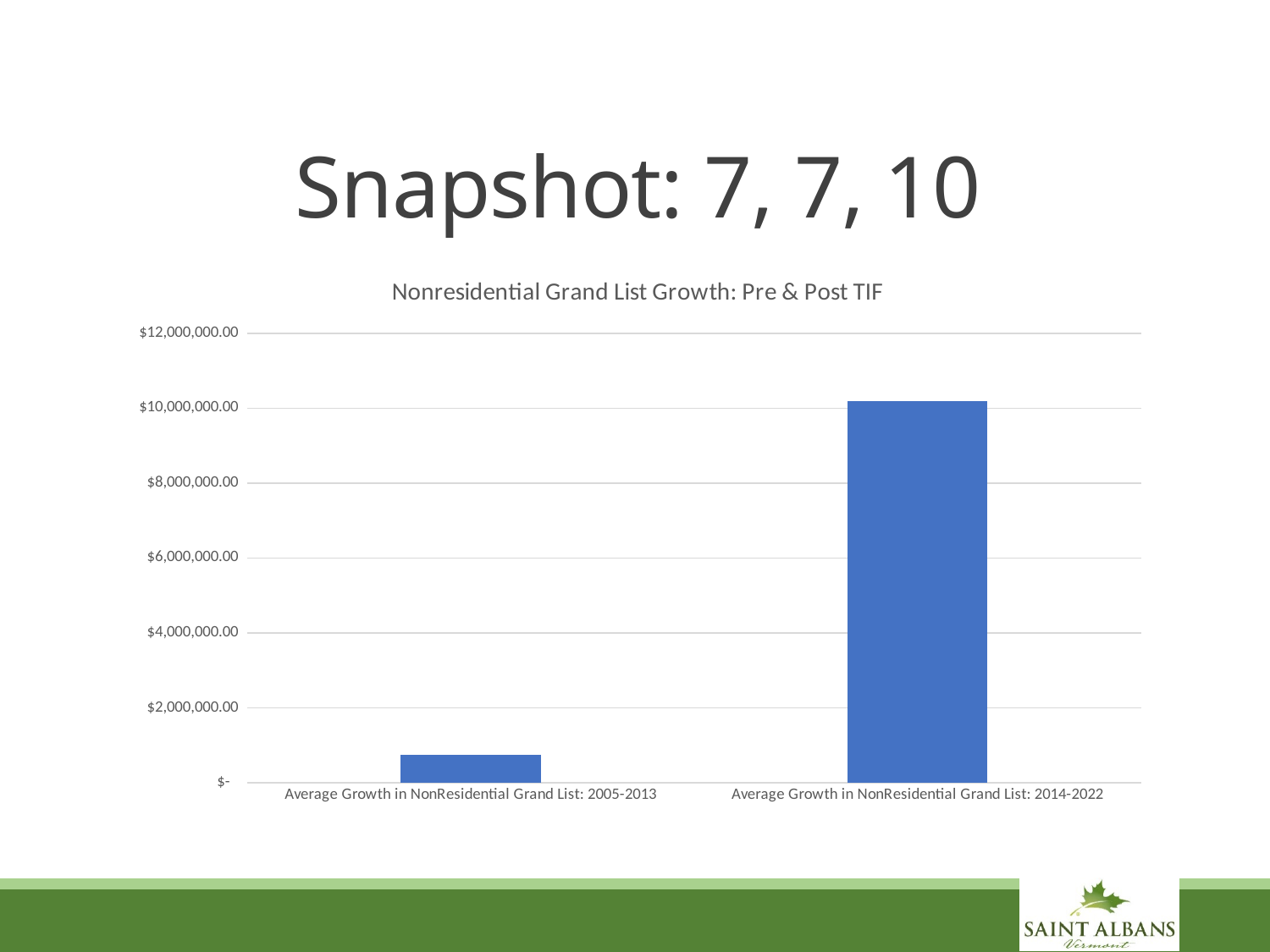
What is the title of the chart? Nonresidential Grand List Growth: Pre & Post TIF What kind of chart is shown on the slide? bar chart Is the value for Average Growth in NonResidential Grand List: 2005-2013 greater or less than $2,000,000.00? less Which category has the highest value? Average Growth in NonResidential Grand List: 2014-2022 Which is larger: the value for 2005-2013 or the value for 2014-2022? 2014-2022 How many bars are plotted in the chart? 2 Is the value for Average Growth in NonResidential Grand List: 2014-2022 greater or less than $8,000,000.00? greater Which category has the lowest value? Average Growth in NonResidential Grand List: 2005-2013 What is the highest value labelled on the vertical axis? $12,000,000.00 Do the values rise or fall from the left bar to the right bar? rise Is the value for Average Growth in NonResidential Grand List: 2014-2022 greater or less than $12,000,000.00? less